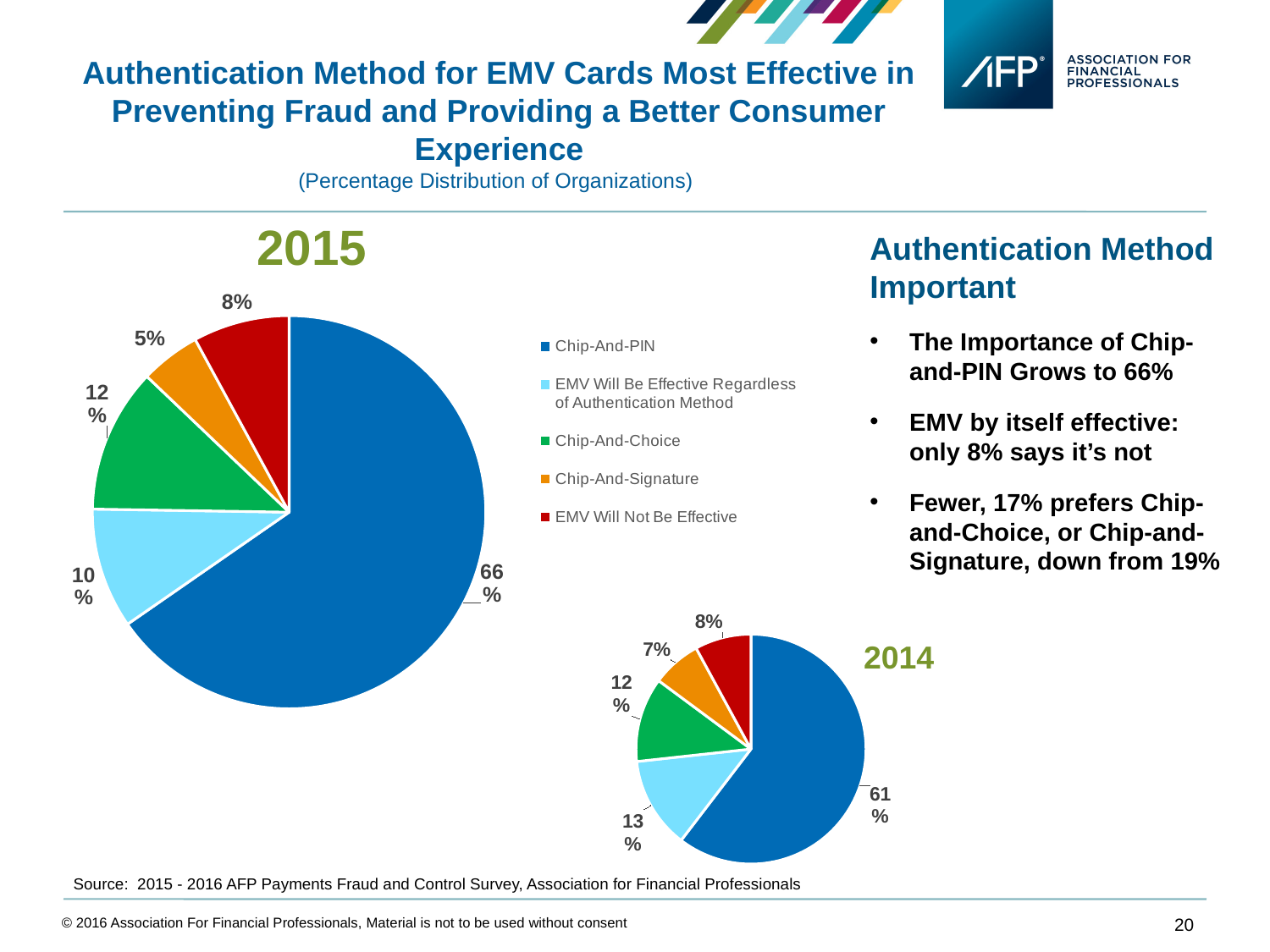
In the 2014 pie chart, what share of organizations chose Chip-And-PIN? 61% What is the difference between the Chip-And-PIN share in 2015 and in 2014? 5% In the 2014 pie chart, what percentage is shown for EMV Will Be Effective Regardless of Authentication Method? 13% In the 2015 pie chart, what percentage is shown for Chip-And-Signature? 5% In the 2014 pie chart, which is larger: Chip-And-Choice or Chip-And-Signature? Chip-And-Choice In the legend, which category is shown in red? EMV Will Not Be Effective How many entries does the legend list? 5 What type of chart is used to show the 2014 data? Pie chart In the 2015 pie chart, which category has the smallest slice? Chip-And-Signature In the 2015 pie chart, which category has the largest slice? Chip-And-PIN How many slices does the 2015 pie chart have? 5 In the 2015 pie chart, what share of organizations chose Chip-And-PIN? 66%